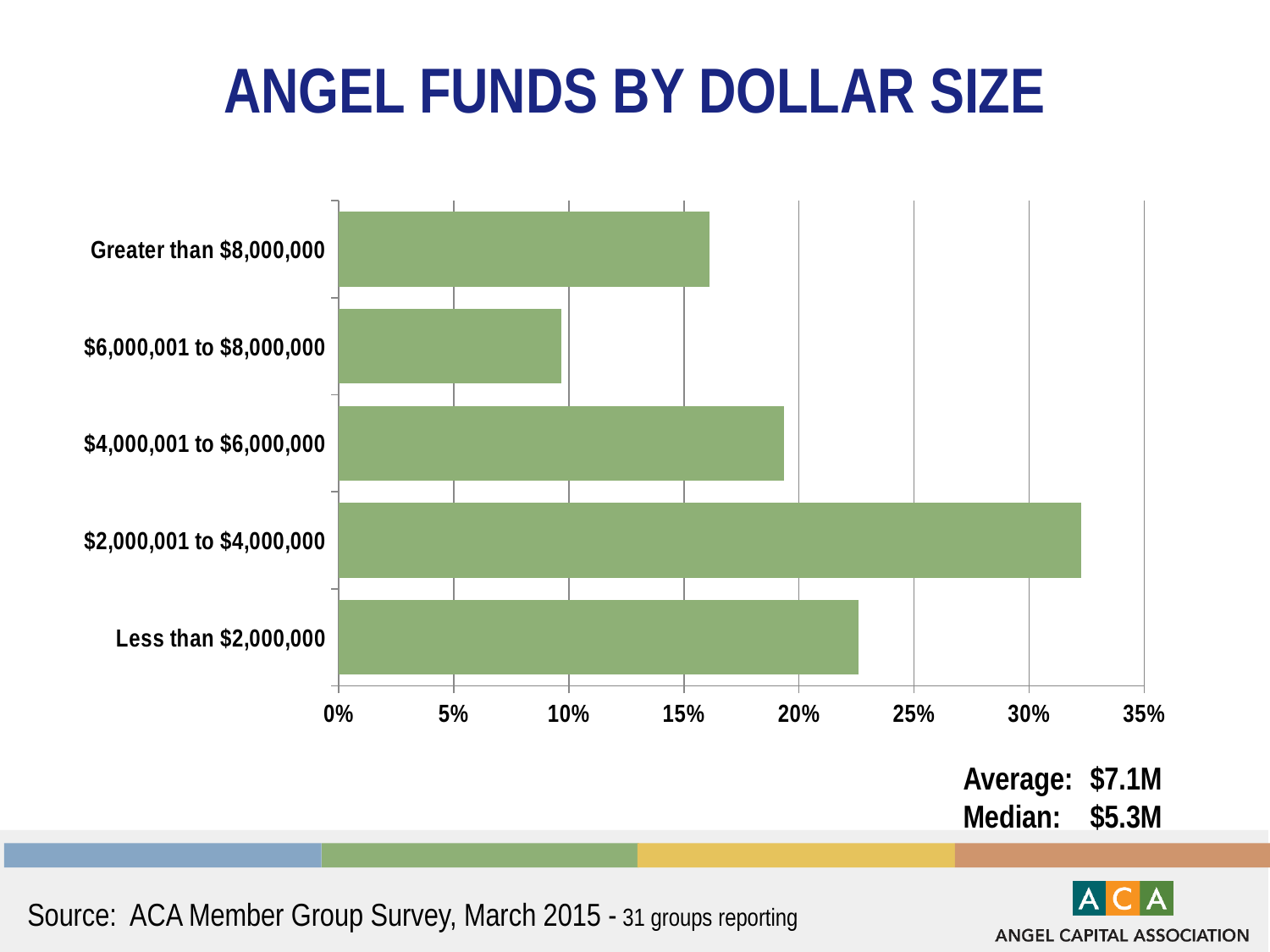
Is the value for "$2,000,001 to $4,000,000" greater or less than 30%? greater Is the value for "$4,000,001 to $6,000,000" greater or less than 20%? less Which fund size category has the highest share of angel funds? $2,000,001 to $4,000,000 How many fund size categories are plotted in the chart? 5 Is the value for "Greater than $8,000,000" greater or less than 15%? greater Which has a larger share: "Less than $2,000,000" or "Greater than $8,000,000"? Less than $2,000,000 What is the title of the chart on the slide? ANGEL FUNDS BY DOLLAR SIZE Which has a larger share: "$4,000,001 to $6,000,000" or "$6,000,001 to $8,000,000"? $4,000,001 to $6,000,000 What kind of chart is shown on the slide? bar chart Which fund size category has the lowest share of angel funds? $6,000,001 to $8,000,000